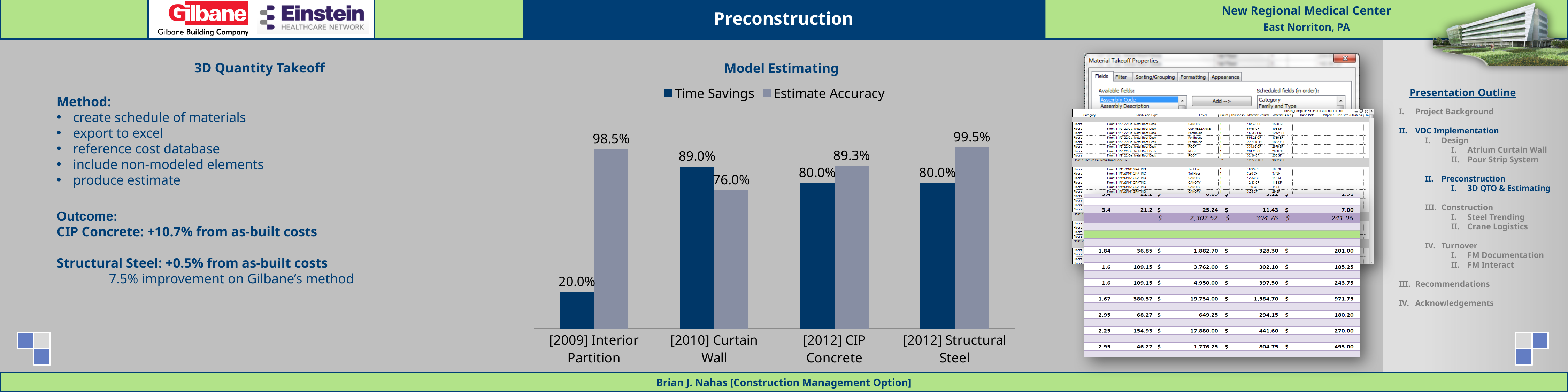
What is the difference between the Estimate Accuracy and Time Savings values for [2009] Interior Partition? 78.5% What is the Estimate Accuracy value for [2012] Structural Steel? 99.5% What kind of chart is shown under the heading Model Estimating? Bar chart How many categories are shown on the x axis of the chart? 4 What is the Estimate Accuracy value for [2010] Curtain Wall? 76.0% What is the title of the chart? Model Estimating Which is larger for [2010] Curtain Wall: Time Savings or Estimate Accuracy? Time Savings What is the Time Savings value for [2012] CIP Concrete? 80.0% How many series does the chart legend list? 2 What is the Time Savings value for [2009] Interior Partition? 20.0% Which category has the lowest Estimate Accuracy value? [2010] Curtain Wall Which category has the highest Time Savings value? [2010] Curtain Wall